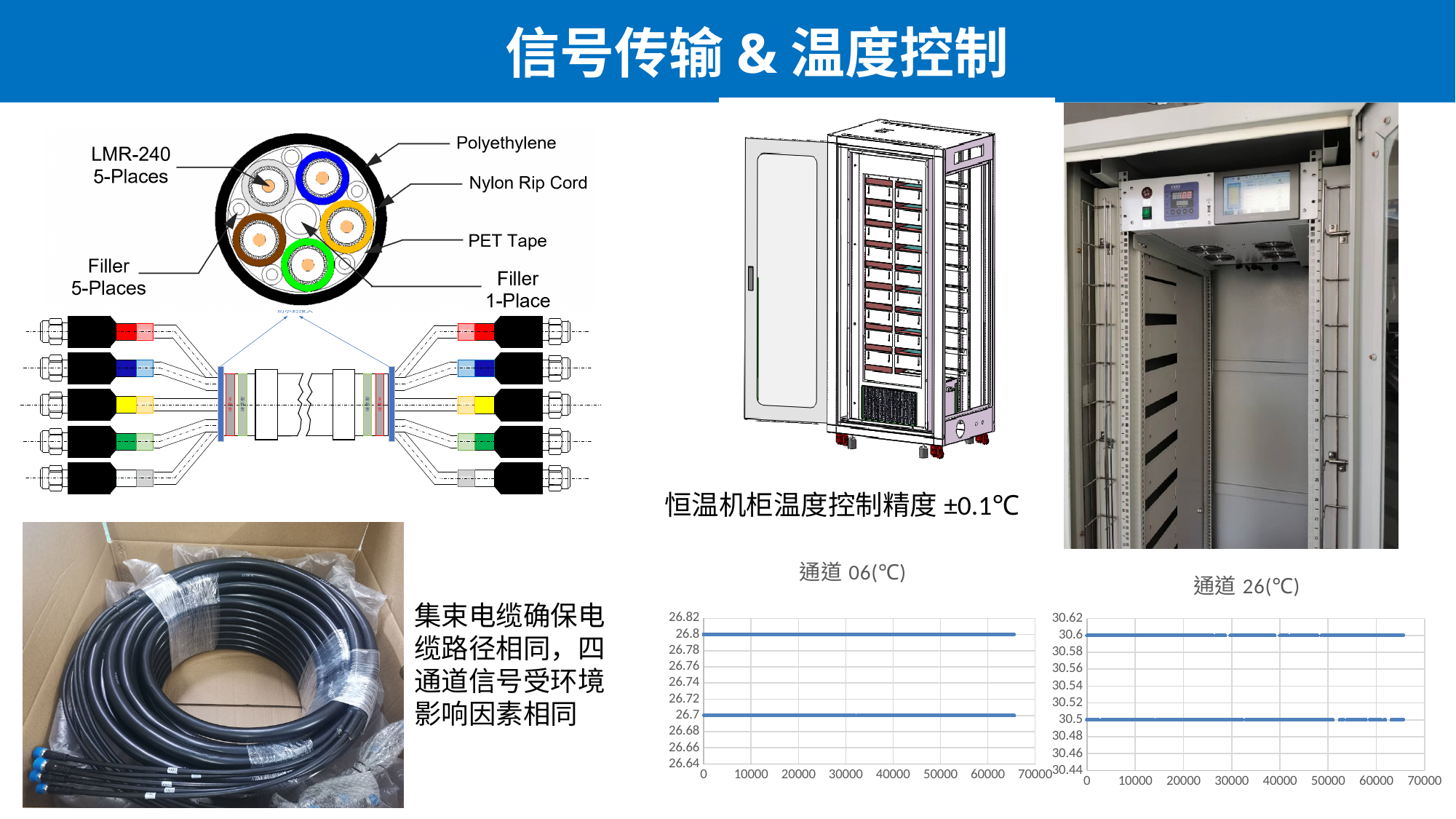
What kind of chart is the "通道 06(℃)" chart? scatter chart In the "通道 06(℃)" chart, do the plotted values rise, fall, or stay flat along the x axis? stay flat Which chart shows higher temperature values, "通道 06(℃)" or "通道 26(℃)"? 通道 26(℃) In the "通道 26(℃)" chart, at which two temperature levels do the plotted points lie? 30.6 and 30.5 What is the highest y-axis tick label on the "通道 26(℃)" chart? 30.62 In the "通道 06(℃)" chart, at which two temperature levels do the plotted points lie? 26.8 and 26.7 In the "通道 06(℃)" chart, is the upper band of points greater or less than 26.78? greater In the "通道 26(℃)" chart, what is the difference between the upper and lower bands of points? 0.1 What is the largest x-axis tick label on the "通道 06(℃)" chart? 70000 In the "通道 06(℃)" chart, what is the difference between the upper and lower bands of points? 0.1 In the "通道 26(℃)" chart, is the lower band of points greater or less than 30.52? less